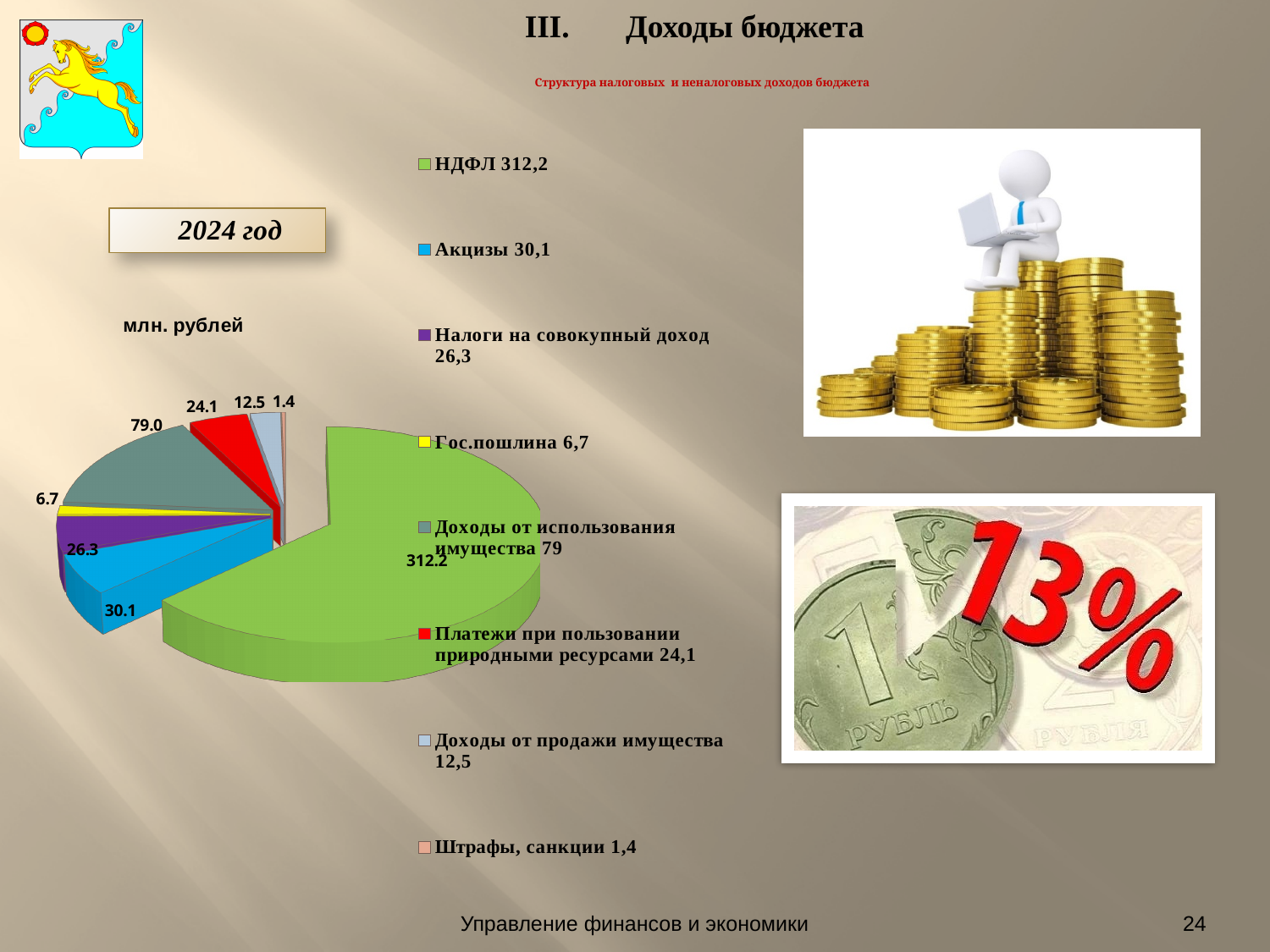
How many slices does the pie chart have? 8 What is the difference between the values for Акцизы and Налоги на совокупный доход? 3.8 Which category has the largest slice in the pie chart? НДФЛ What is the value shown for НДФЛ in the pie chart? 312.2 What type of chart is shown on the slide? Pie chart What unit is stated for the values in the pie chart? млн. рублей What is the value shown for Доходы от использования имущества in the pie chart? 79.0 Which is larger, Платежи при пользовании природными ресурсами or Доходы от продажи имущества? Платежи при пользовании природными ресурсами Which category has the smallest slice in the pie chart? Штрафы, санкции What is the difference between the values for НДФЛ and Доходы от использования имущества? 233.2 What is the value shown for Штрафы, санкции in the pie chart? 1.4 What is the value shown for Акцизы in the pie chart? 30.1